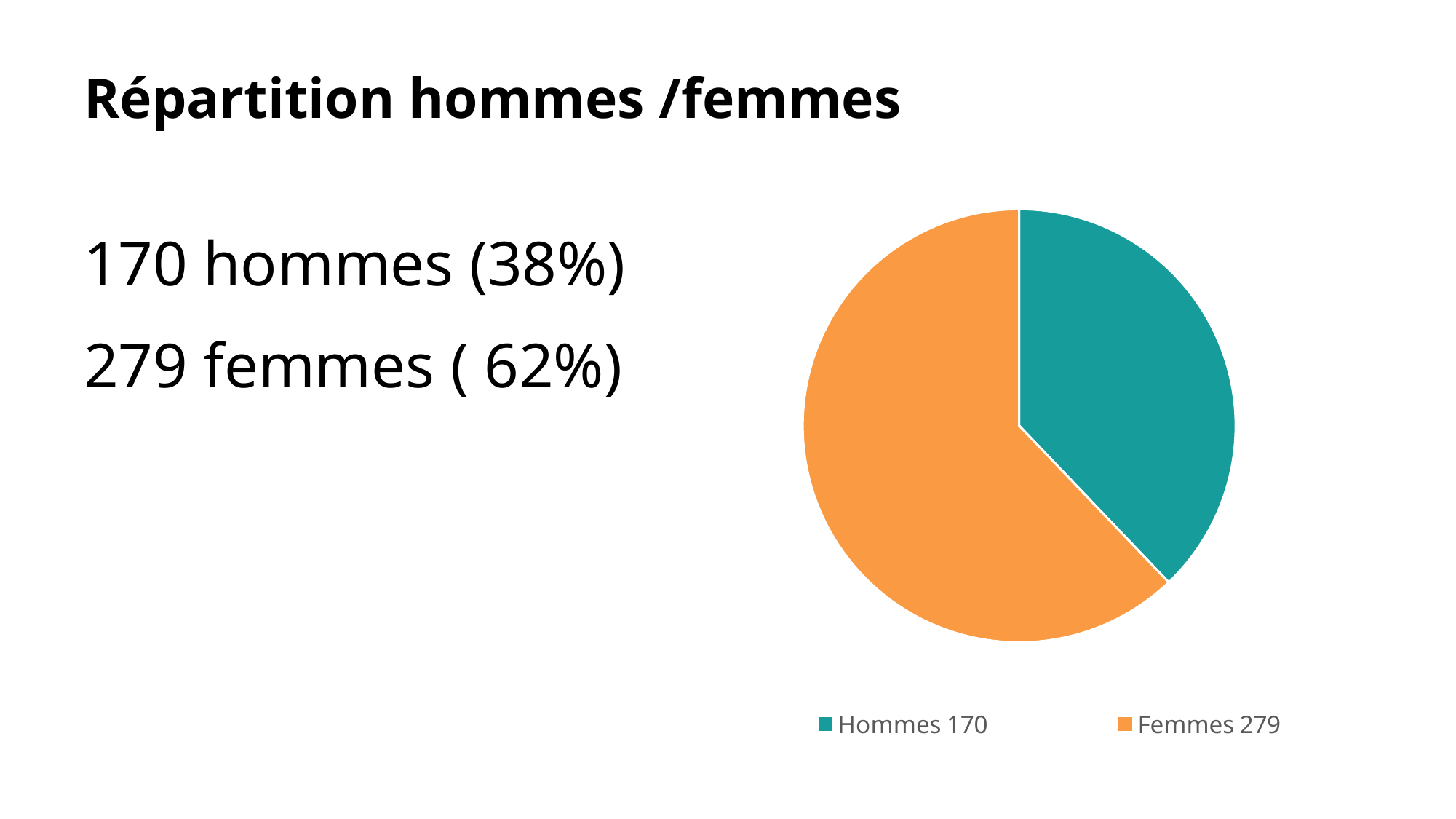
How many slices does the pie chart have? 2 What is the difference between the Femmes and Hommes values in the pie chart? 109 Which slice of the pie chart is the smallest? Hommes What kind of chart is shown on the slide? pie chart What is the value for Femmes in the pie chart? 279 What is the total of the two slices in the pie chart? 449 What share of the pie does the Hommes slice represent, as stated on the slide? 38% Which slice of the pie chart is the largest? Femmes What is the value for Hommes in the pie chart? 170 How many entries does the legend of the pie chart list? 2 Which is larger in the pie chart, Hommes or Femmes? Femmes What colour is the Femmes slice in the pie chart? orange